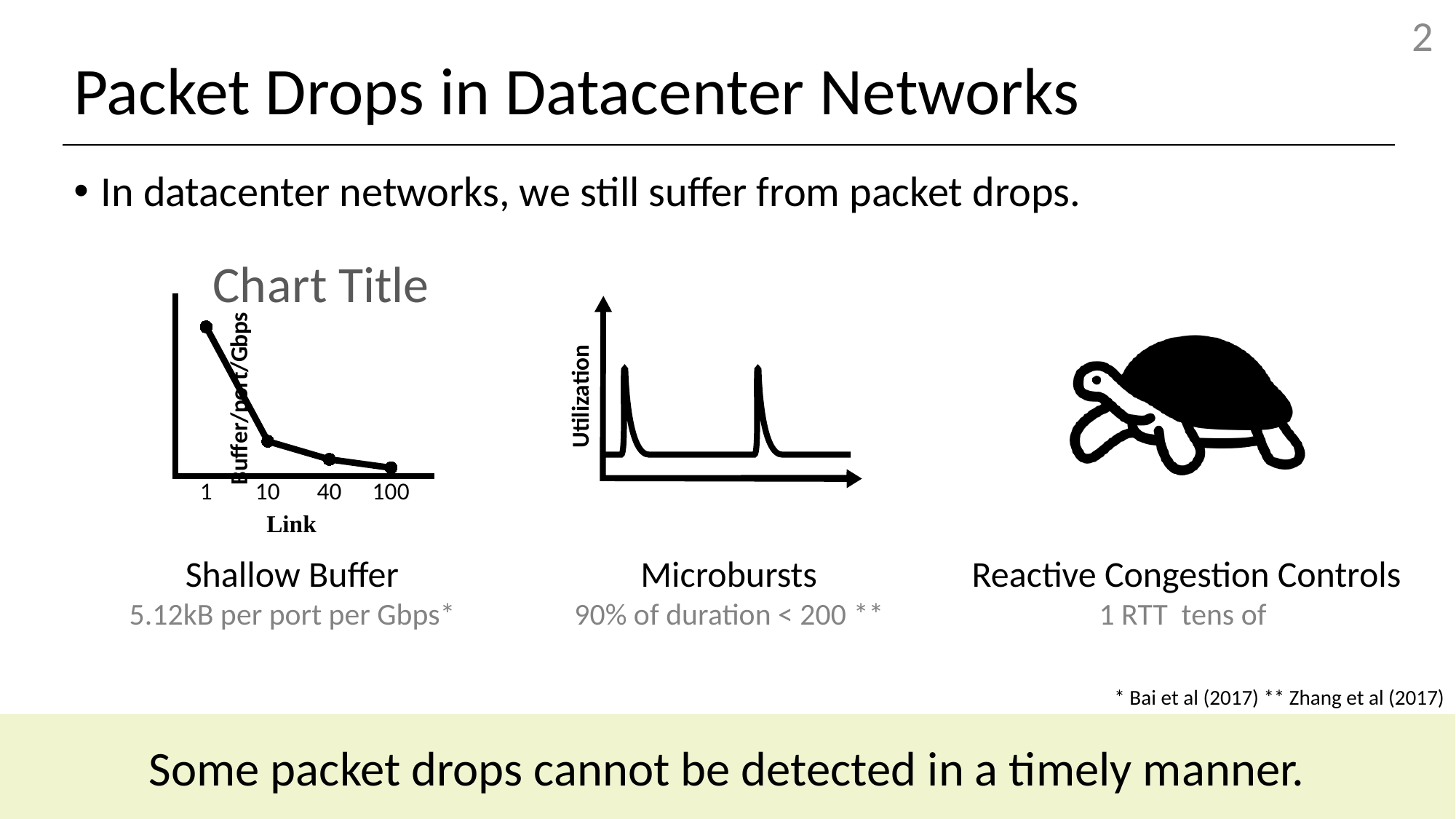
In the left chart titled "Chart Title", which Link value has the highest Buffer/port/Gbps? 1 What is the y-axis label of the left chart titled "Chart Title"? Buffer/port/Gbps In the left chart titled "Chart Title", what are the tick labels shown on the x axis? 1, 10, 40, 100 What is the x-axis label of the left chart titled "Chart Title"? Link In the left chart titled "Chart Title", is the Buffer/port/Gbps value larger at Link 1 or at Link 10? 1 In the left chart titled "Chart Title", is the Buffer/port/Gbps value larger at Link 10 or at Link 100? 10 In the left chart titled "Chart Title", which Link value has the lowest Buffer/port/Gbps? 100 In the left chart titled "Chart Title", how many data points are plotted? 4 What kind of chart is shown under the title "Chart Title" on the left of the slide? line chart In the left chart titled "Chart Title", do the values rise or fall as Link increases along the x axis? fall